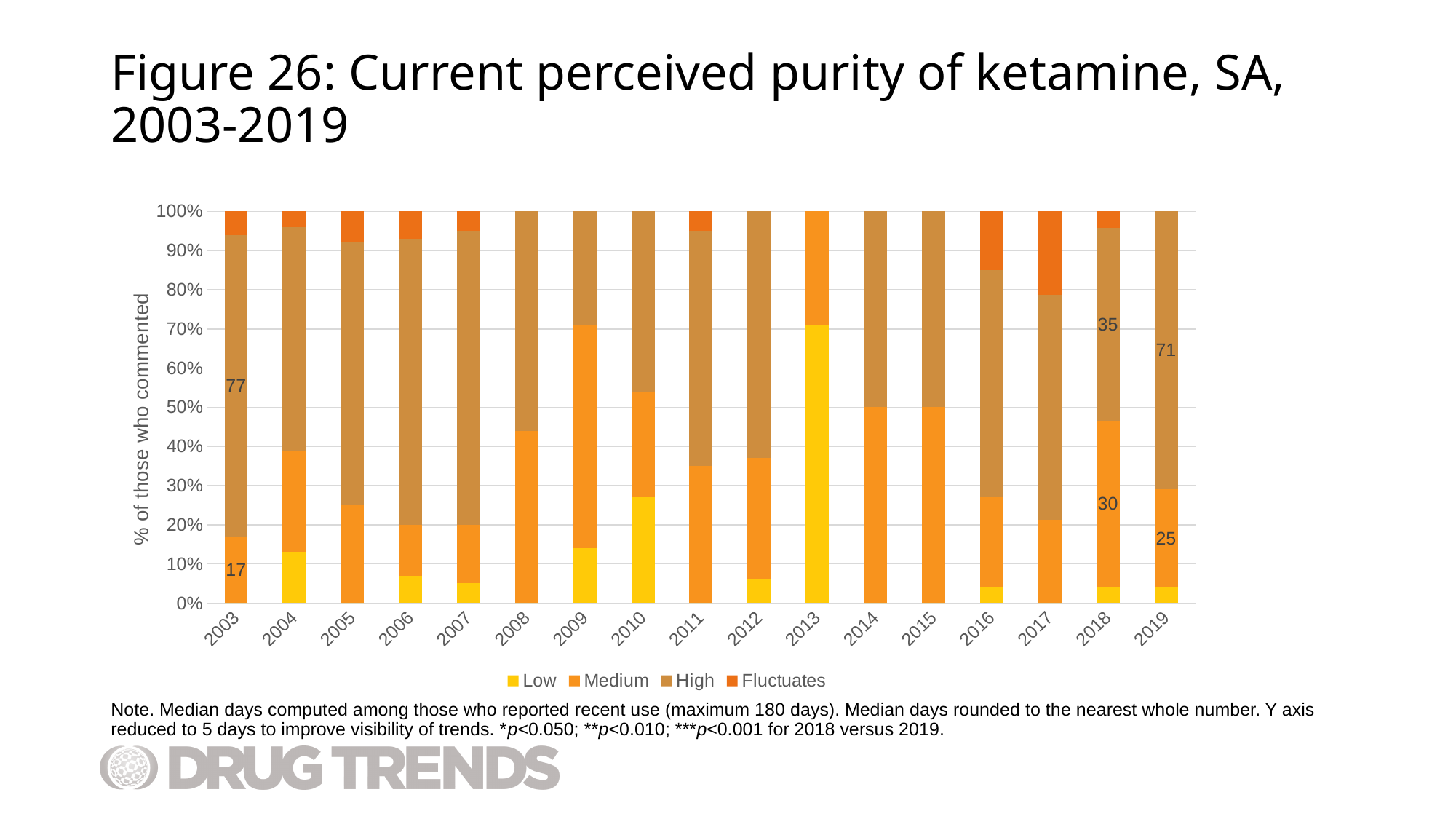
How many years are shown on the x axis? 17 What is the value labelled for the High series in 2019? 71 What kind of chart is shown on the slide? Stacked bar chart What is the value labelled for the Medium series in 2019? 25 Is the Low segment for 2013 greater or less than 50%? greater Which is larger, the labelled Medium value for 2018 or for 2019? 2018 Which year has the largest Low segment? 2013 What is the difference between the labelled High values for 2019 and 2018? 36 What is the value labelled for the Medium series in 2003? 17 How many series does the legend list? 4 What is the value labelled for the High series in 2003? 77 What is the value labelled for the High series in 2018? 35